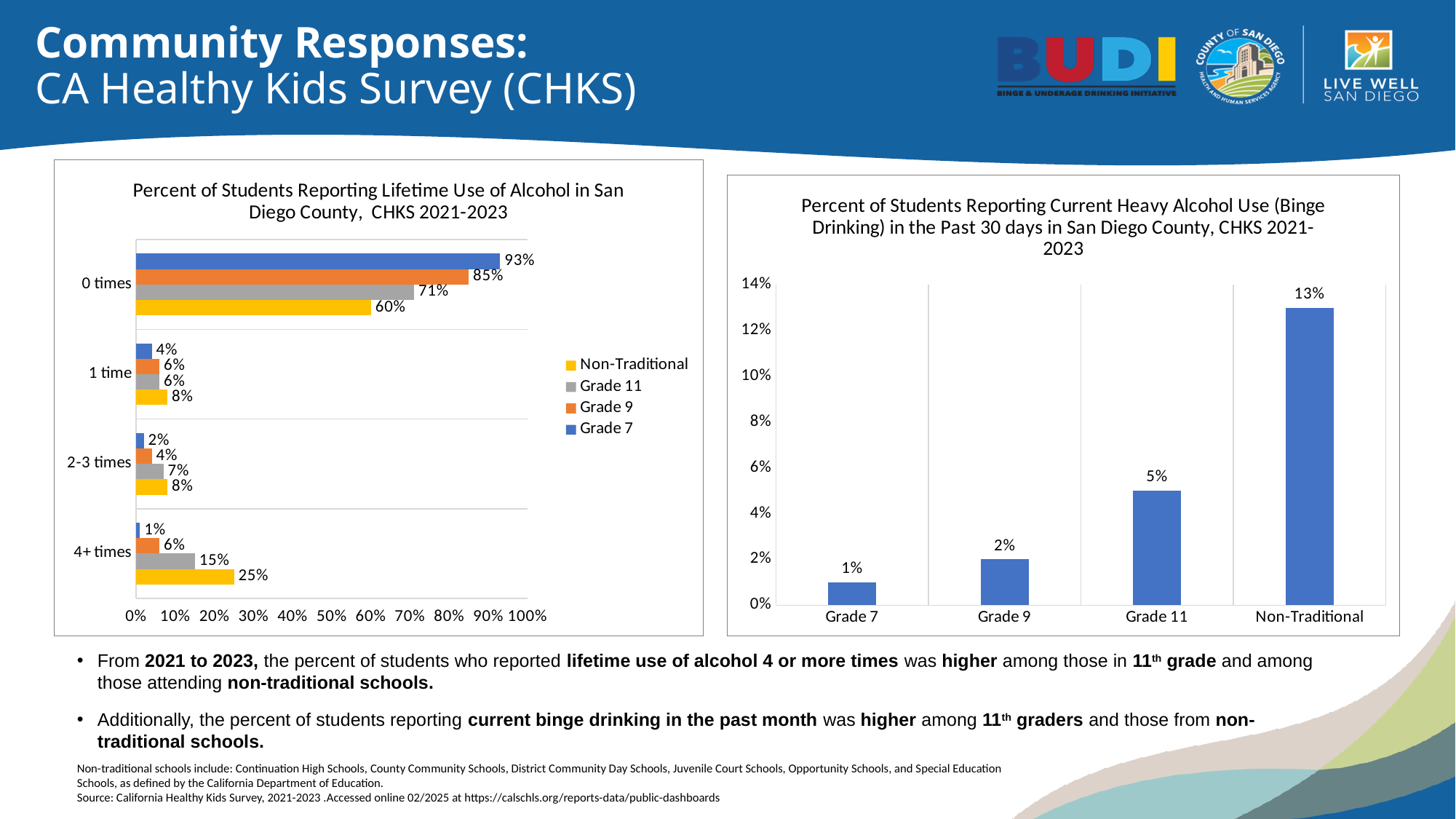
In the left chart (Percent of Students Reporting Lifetime Use of Alcohol), what is the value for Grade 11 in the 2-3 times category? 7% What kind of chart is the right chart (Percent of Students Reporting Current Heavy Alcohol Use)? bar chart In the left chart (Percent of Students Reporting Lifetime Use of Alcohol), what is the value for Grade 7 in the 0 times category? 93% In the left chart (Percent of Students Reporting Lifetime Use of Alcohol), what is the value for Non-Traditional in the 4+ times category? 25% In the right chart (Percent of Students Reporting Current Heavy Alcohol Use), do the values rise or fall from Grade 7 to Non-Traditional? rise In the right chart (Percent of Students Reporting Current Heavy Alcohol Use), which category has the highest value? Non-Traditional In the left chart (Percent of Students Reporting Lifetime Use of Alcohol), which series has the highest value in the 4+ times category? Non-Traditional In the left chart (Percent of Students Reporting Lifetime Use of Alcohol), what is the difference between Grade 7 and Non-Traditional in the 0 times category? 33% In the right chart (Percent of Students Reporting Current Heavy Alcohol Use), what is the difference between Non-Traditional and Grade 9? 11% In the left chart (Percent of Students Reporting Lifetime Use of Alcohol), how many series does the legend list? 4 In the left chart (Percent of Students Reporting Lifetime Use of Alcohol), which series has the lowest value in the 0 times category? Non-Traditional In the right chart (Percent of Students Reporting Current Heavy Alcohol Use), what is the value for Grade 11? 5%